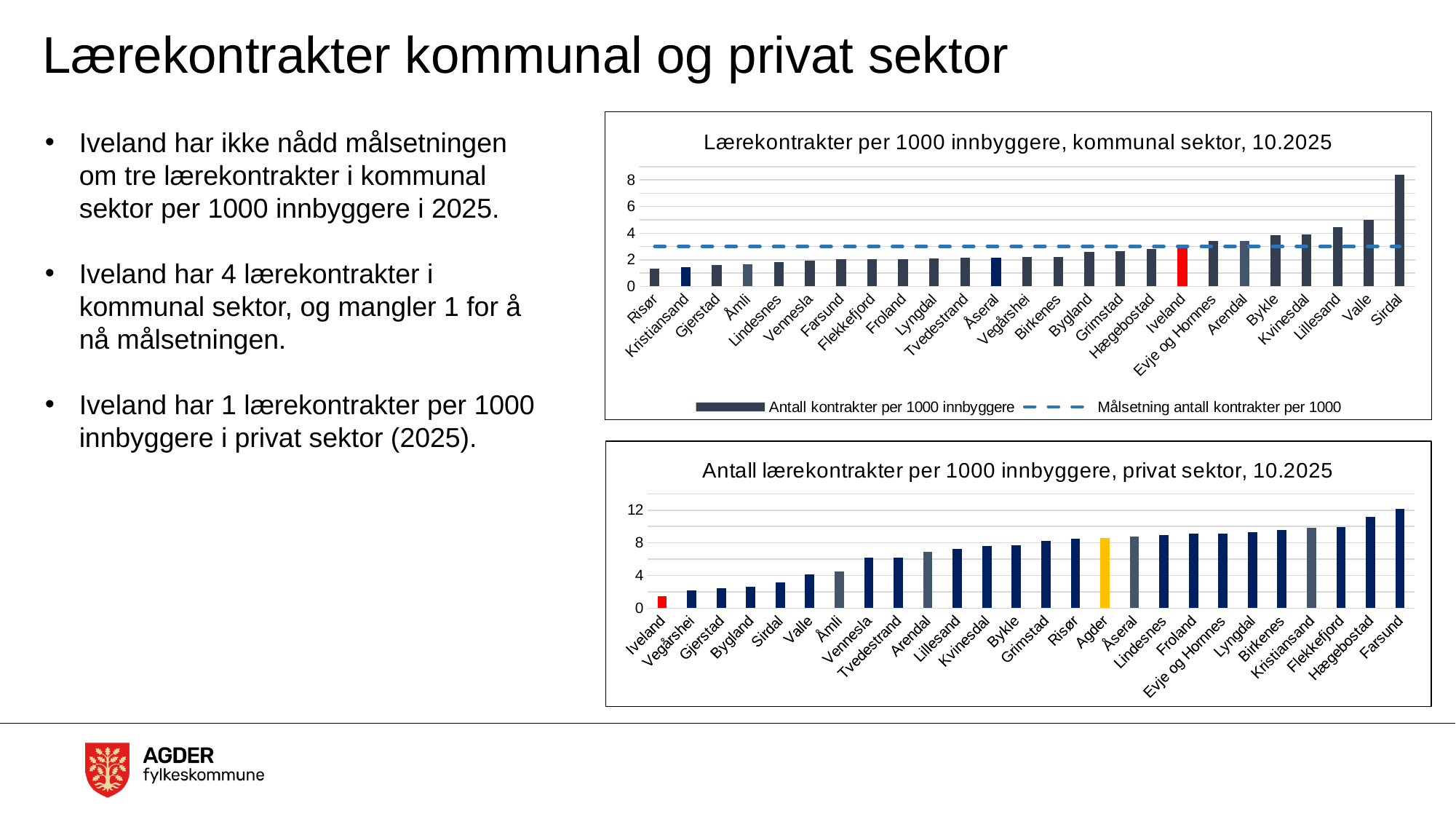
In the top chart (kommunal sektor), is the value for Valle greater or less than 4? greater In the bottom chart (privat sektor), is the value for Sirdal greater or less than 4? less In the bottom chart (privat sektor), which municipality has the highest value? Farsund In the top chart (kommunal sektor), which municipality has the highest value? Sirdal In the top chart (kommunal sektor), is the value for Risør greater or less than 2? less In the top chart (kommunal sektor), what colour is the bar for Iveland? red What kind of chart is the top chart, 'Lærekontrakter per 1000 innbyggere, kommunal sektor, 10.2025'? bar chart In the bottom chart (privat sektor), which municipality has the lowest value? Iveland In the top chart (kommunal sektor), which has the larger value, Valle or Lillesand? Valle Do the values in the bottom chart (privat sektor) rise or fall from left to right along the x axis? rise How many series does the legend of the top chart (kommunal sektor) list? 2